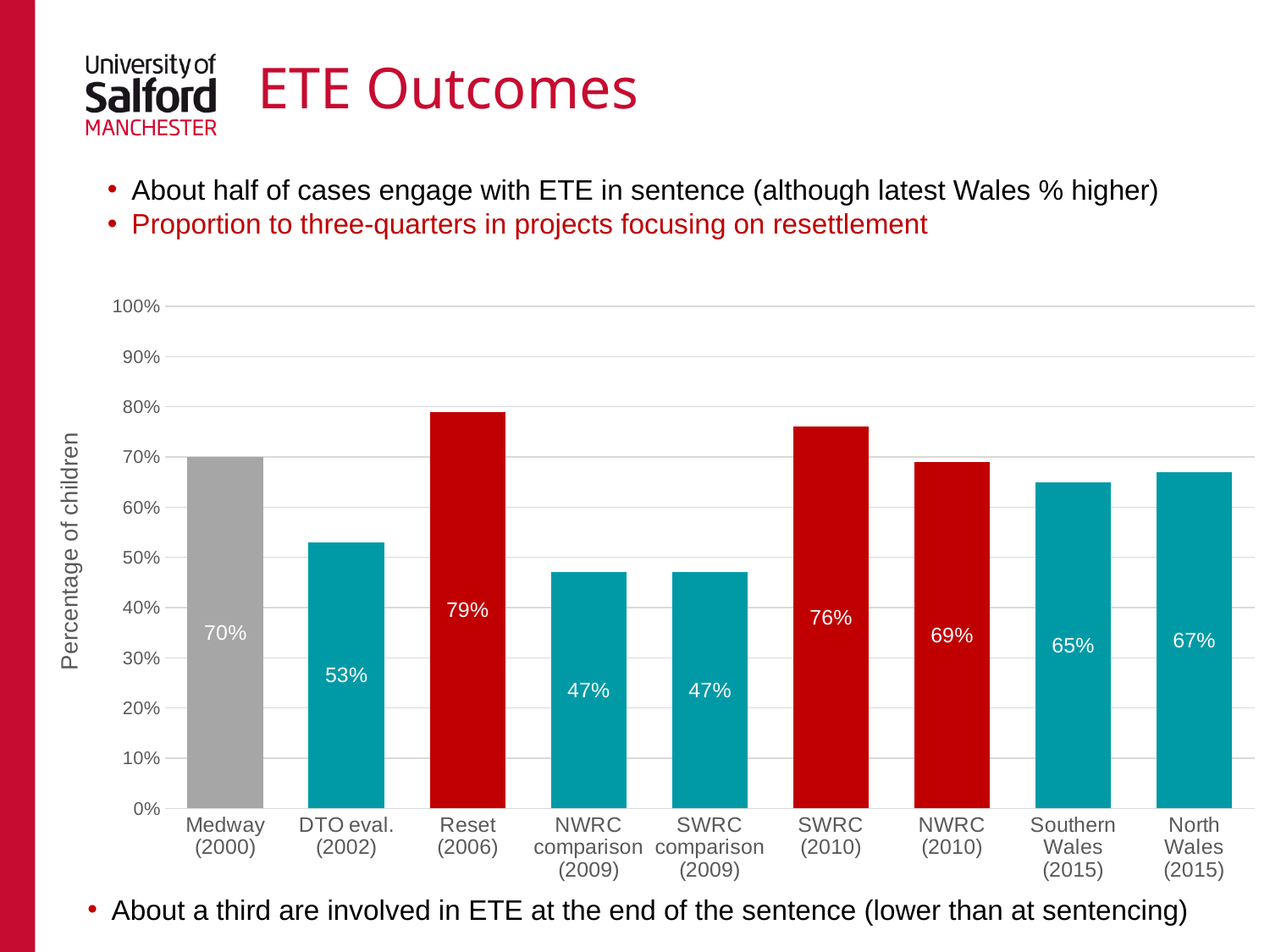
What is the label of the y axis? Percentage of children What is the lowest value shown on the chart? 47% How many categories are shown on the x axis? 9 Which category has the highest value? Reset (2006) What is the value for Reset (2006)? 79% What is the value for North Wales (2015)? 67% What is the value for Medway (2000)? 70% What kind of chart is shown on the slide? Bar chart What is the difference between SWRC (2010) and NWRC (2010)? 7% What colour is the bar for Medway (2000)? Grey Which is larger, DTO eval. (2002) or Southern Wales (2015)? Southern Wales (2015) Is the value for Reset (2006) greater or less than 70%? greater